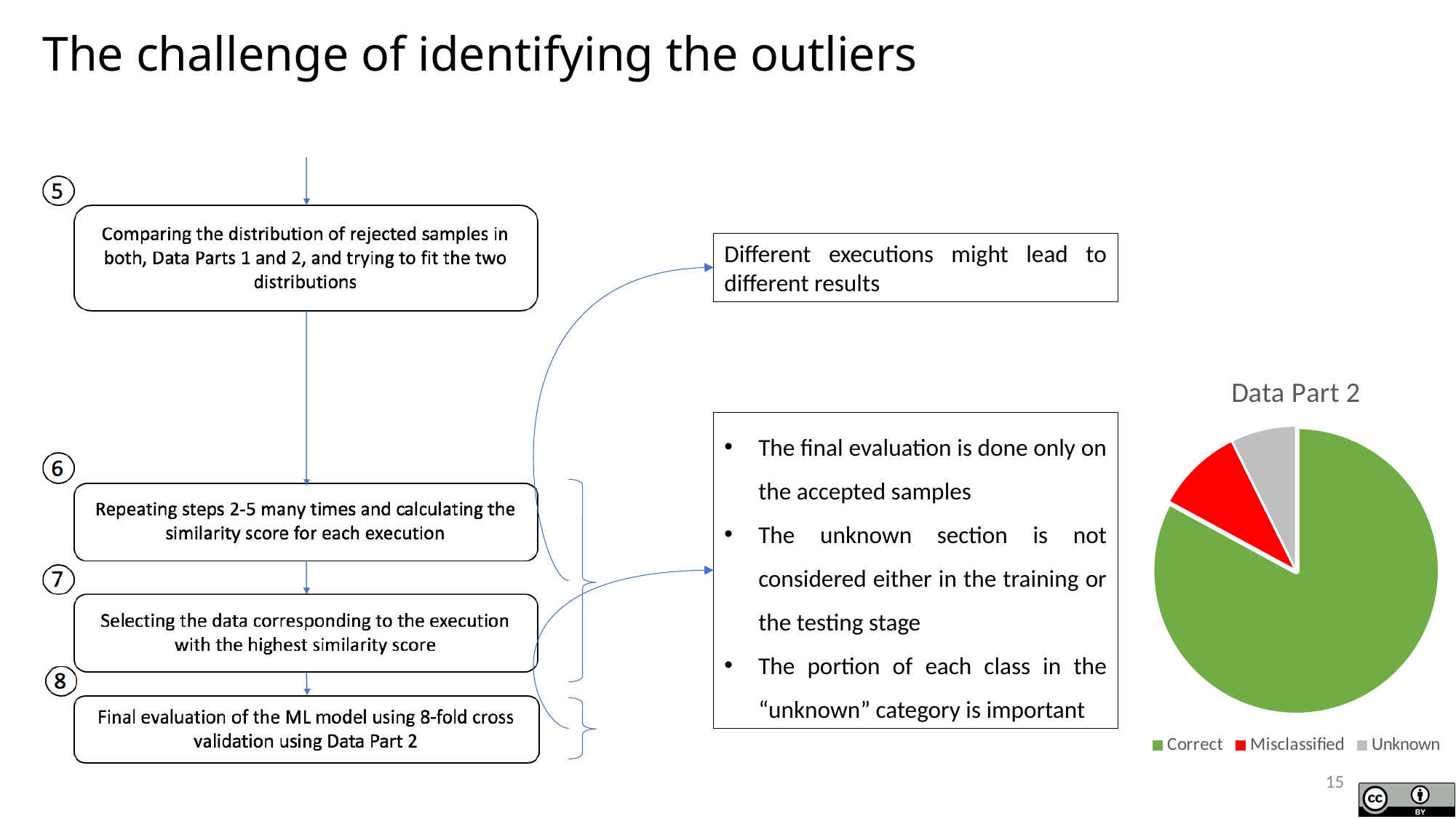
Which category has the largest slice in the pie chart? Correct What is the title of the pie chart? Data Part 2 How many categories does the pie chart's legend list? 3 Which slice is larger in the pie chart, Correct or Unknown? Correct Which slice is larger in the pie chart, Correct or Misclassified? Correct What colour represents the Misclassified category in the pie chart? red How many slices does the pie chart have? 3 What kind of chart is shown on the slide? pie chart